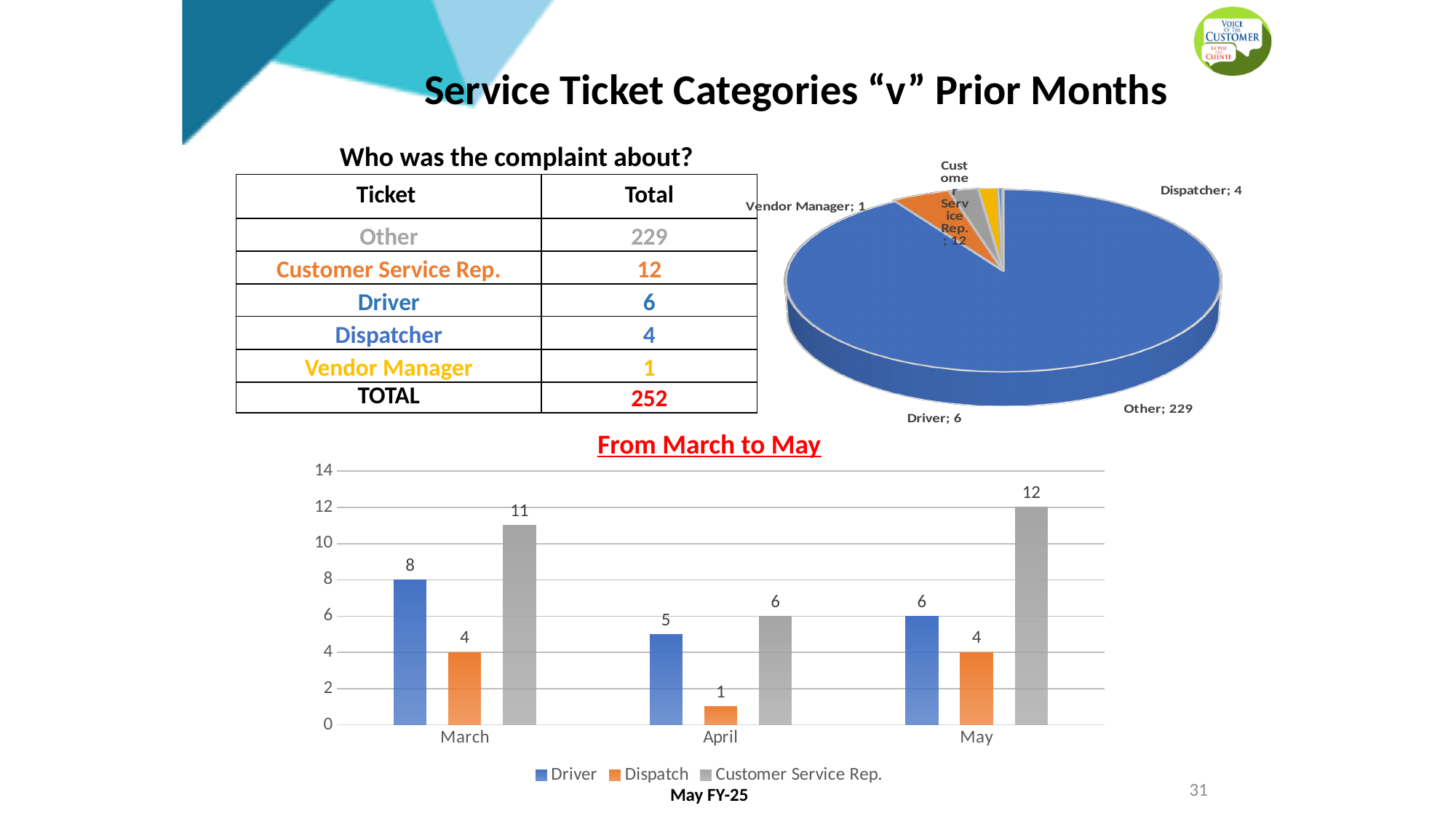
In the bar chart 'From March to May', which month has the lowest Driver value? April What kind of chart is the chart at the top right of the slide? Pie chart In the pie chart at the top right, what is the value for Dispatcher? 4 In the pie chart at the top right, which category has the largest slice? Other In the bar chart 'From March to May', what is the value for Customer Service Rep. in May? 12 In the bar chart 'From March to May', how does the Driver value change from March to April? It falls In the bar chart 'From March to May', what is the value for Driver in March? 8 In the bar chart 'From March to May', is the Driver value in March larger or smaller than the Driver value in May? larger In the bar chart 'From March to May', how many series does the legend list? 3 In the bar chart 'From March to May', what is the difference between the Customer Service Rep. value in May and in April? 6 In the bar chart 'From March to May', what is the value for Dispatch in April? 1 In the bar chart 'From March to May', which month has the highest Customer Service Rep. value? May